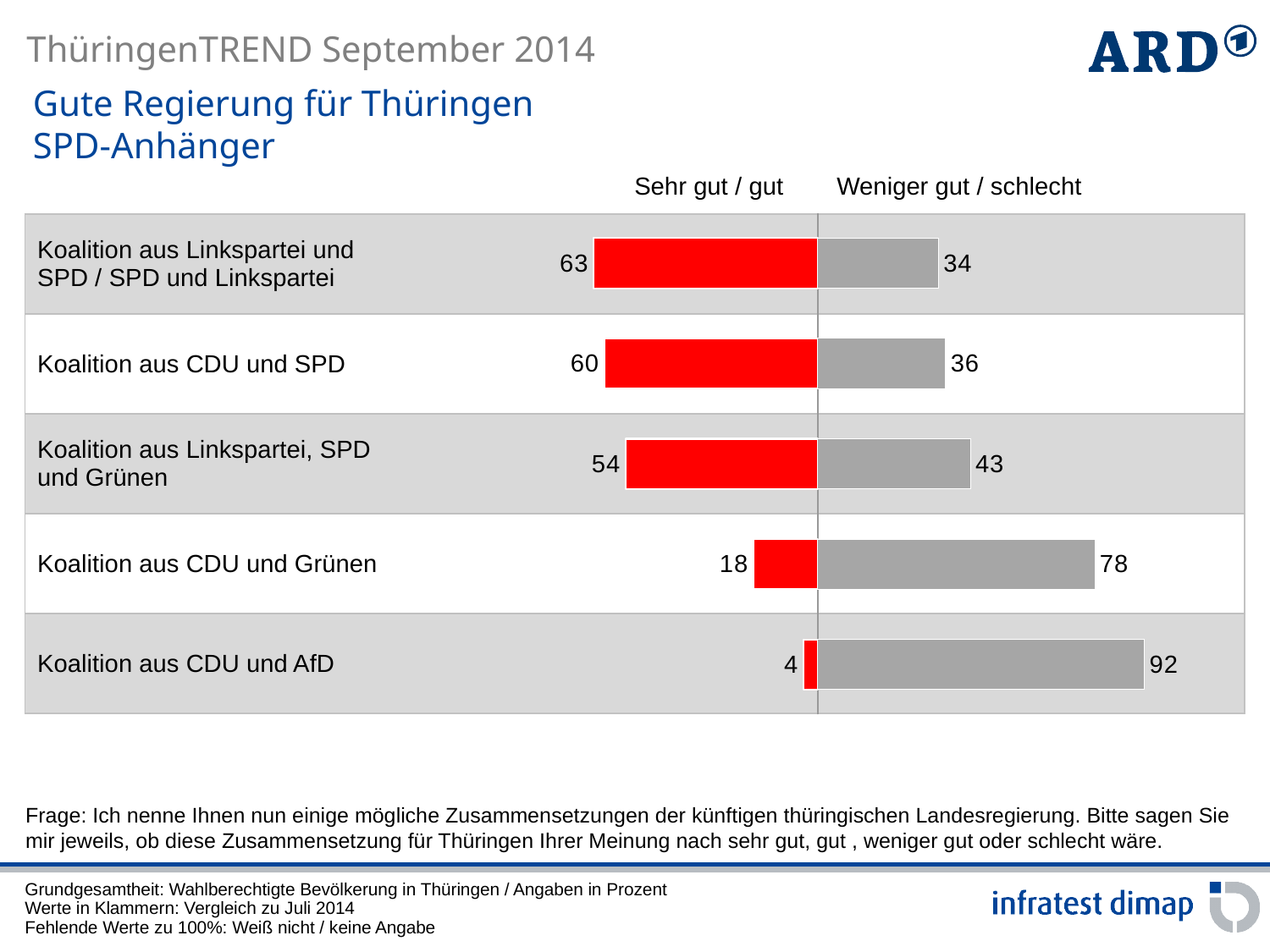
How many series does the chart show? 2 What is the difference between the "Weniger gut / schlecht" and "Sehr gut / gut" values for Koalition aus CDU und Grünen? 60 What is the "Sehr gut / gut" value for Koalition aus CDU und SPD? 60 What is the "Weniger gut / schlecht" value for Koalition aus CDU und AfD? 92 How many coalitions are shown in the chart? 5 Which coalition has the lowest "Sehr gut / gut" value? Koalition aus CDU und AfD Which coalition has the highest "Sehr gut / gut" value? Koalition aus Linkspartei und SPD / SPD und Linkspartei Which colour represents the "Sehr gut / gut" series? Red What kind of chart is shown on the slide? Bar chart Which coalition has the highest "Weniger gut / schlecht" value? Koalition aus CDU und AfD Which is larger for Koalition aus CDU und SPD: the "Sehr gut / gut" value or the "Weniger gut / schlecht" value? Sehr gut / gut What is the "Weniger gut / schlecht" value for Koalition aus Linkspartei, SPD und Grünen? 43